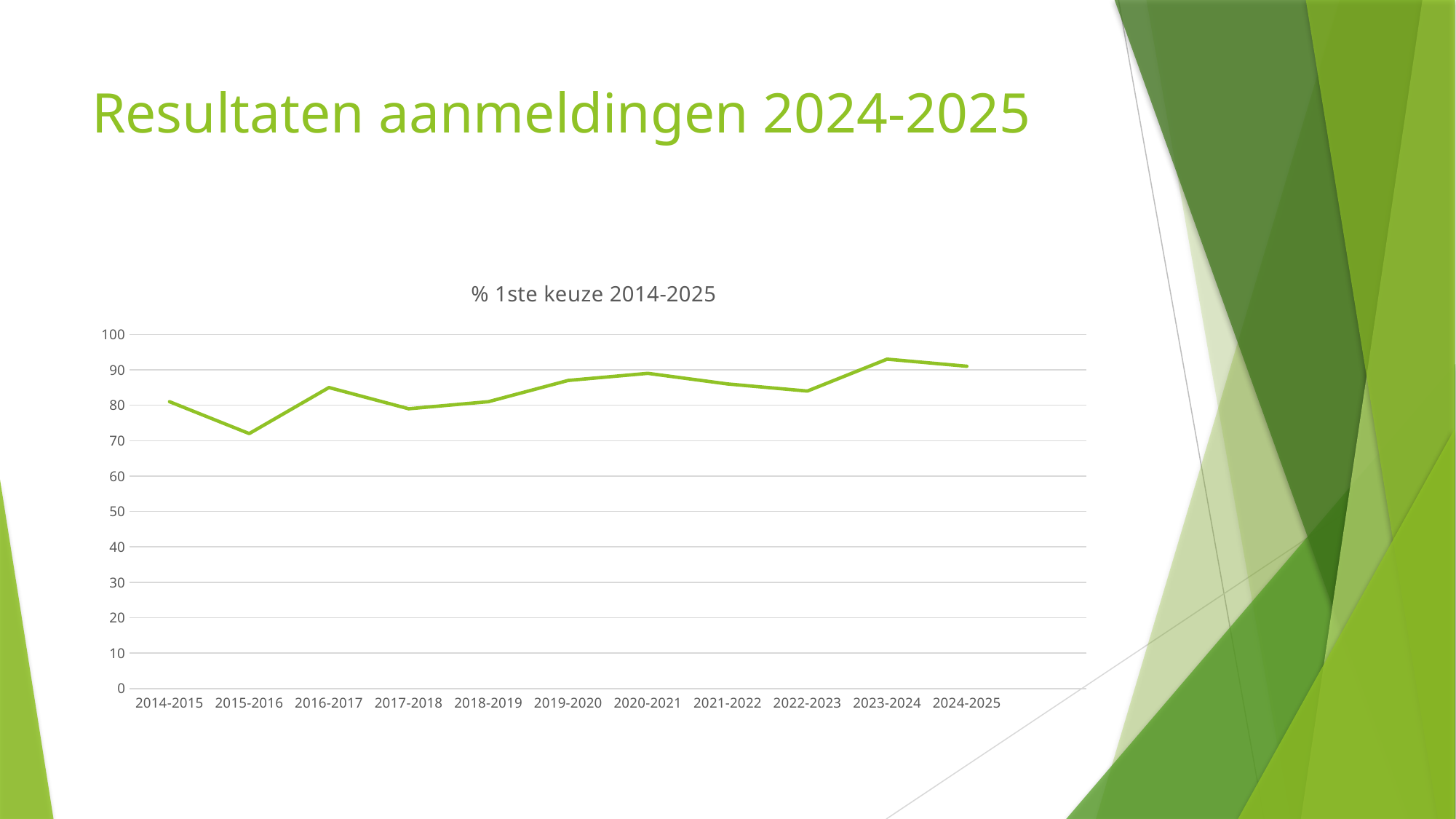
Which is larger, the value for 2020-2021 or the value for 2022-2023? 2020-2021 Which school year has the lowest value? 2015-2016 Is the value for 2023-2024 greater or less than 90? greater Is the value for 2015-2016 greater or less than 80? less Which school year has the highest value? 2023-2024 Is the value for 2022-2023 greater or less than 90? less What kind of chart is shown on the slide? line chart What is the title of the chart? % 1ste keuze 2014-2025 Does the value rise or fall from 2017-2018 to 2020-2021? rise Which is larger, the value for 2015-2016 or the value for 2016-2017? 2016-2017 How many school years are plotted on the x axis? 11